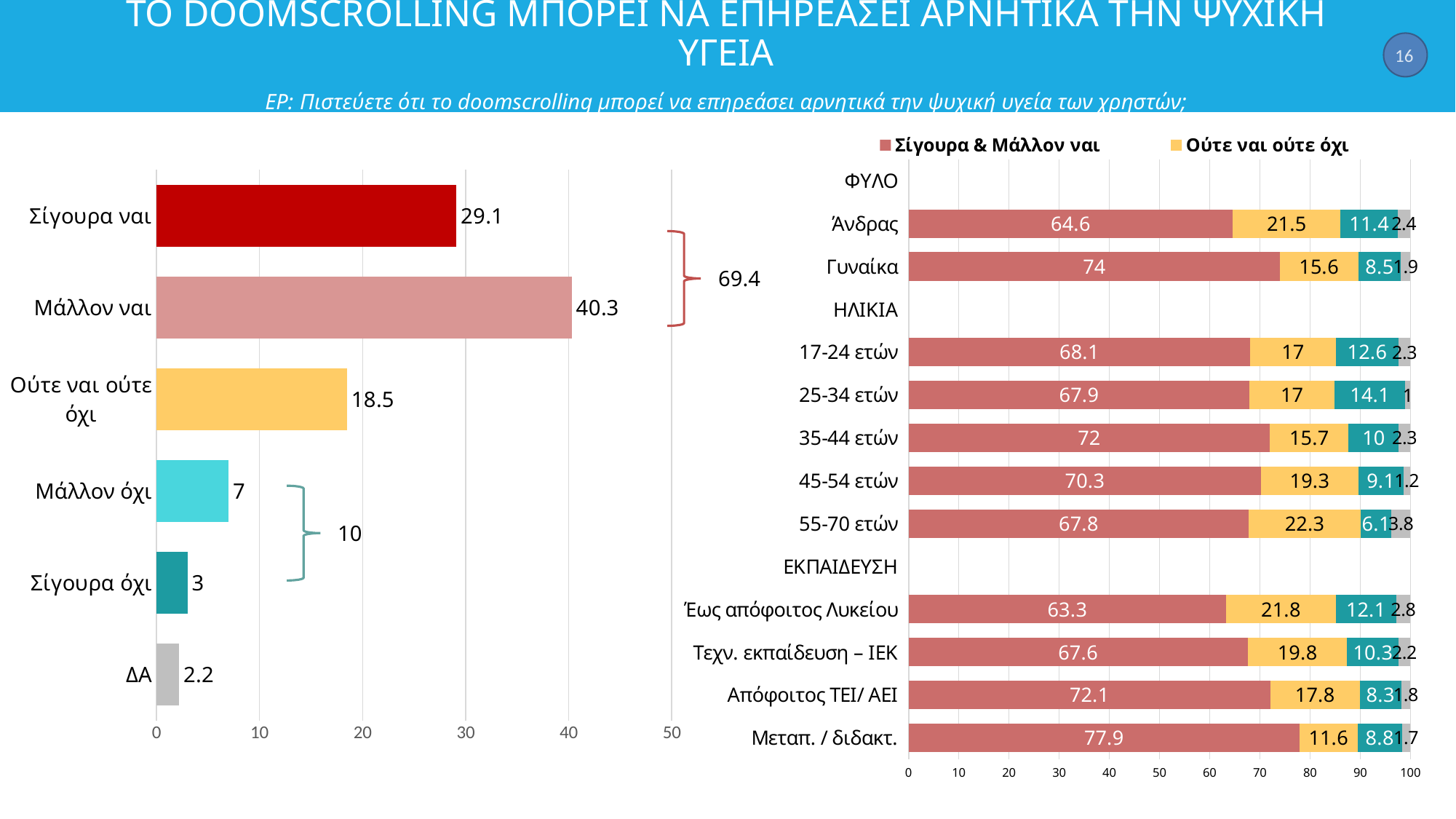
In the right stacked bar chart, what is the Ούτε ναι ούτε όχι value for 55-70 ετών? 22.3 What kind of chart is the chart on the left of the slide? Bar chart In the right stacked bar chart, which category has the highest Σίγουρα & Μάλλον ναι value? Μεταπ. / διδακτ. In the left bar chart, what is the value for Σίγουρα ναι? 29.1 In the left bar chart, what is the value for Μάλλον ναι? 40.3 In the right stacked bar chart, is the Σίγουρα & Μάλλον ναι value larger for Άνδρας or for Γυναίκα? Γυναίκα In the left bar chart, how many categories are shown? 6 In the left bar chart, which category has the highest value? Μάλλον ναι In the right stacked bar chart, how many age groups (ΗΛΙΚΙΑ) are shown? 5 In the left bar chart, which category has the lowest value? ΔΑ In the left bar chart, what is the difference between Μάλλον ναι and Σίγουρα ναι? 11.2 In the right stacked bar chart, what is the Σίγουρα & Μάλλον ναι value for Γυναίκα? 74